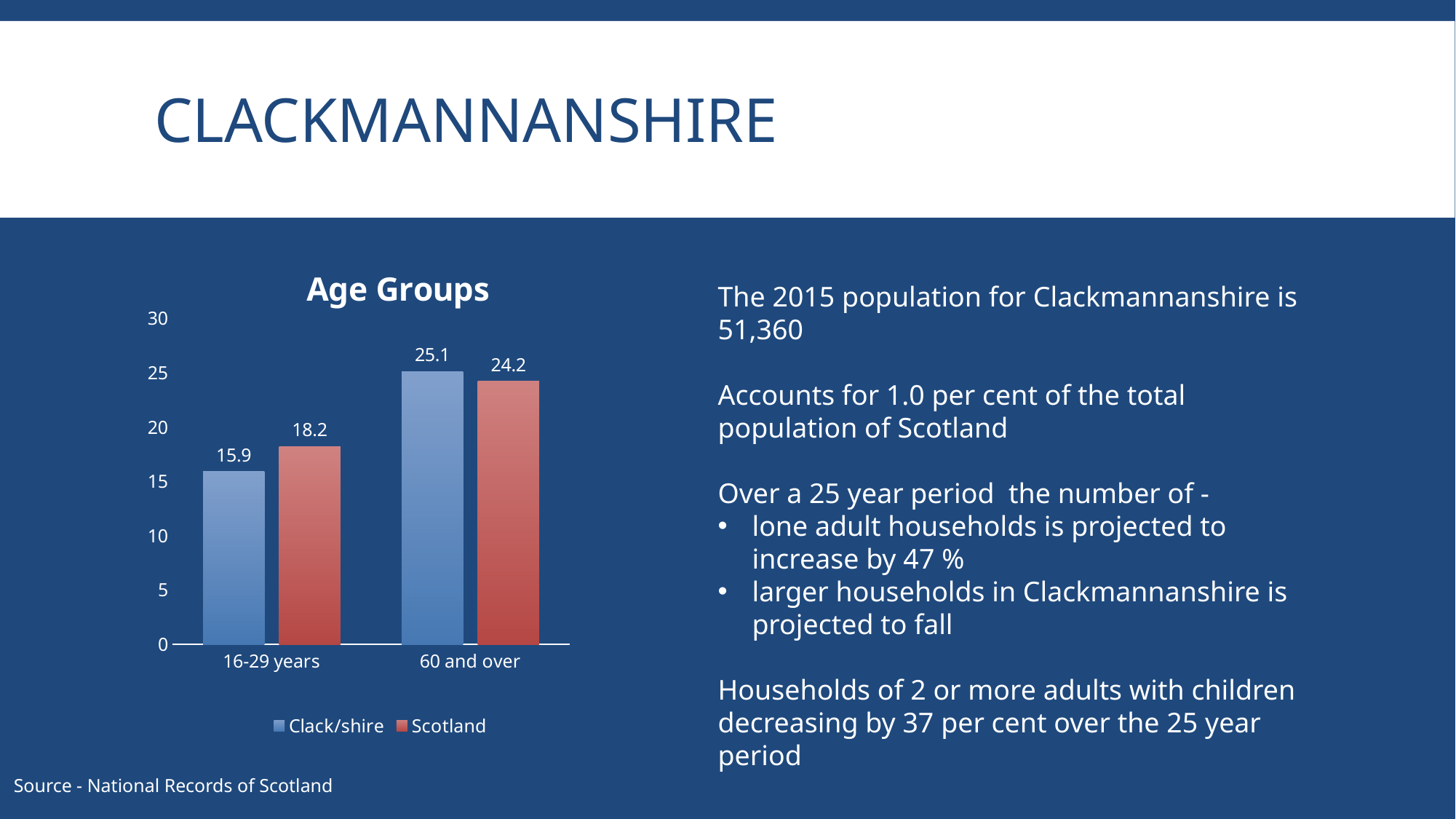
What is the value for Clack/shire in the 16-29 years category? 15.9 Which category has the highest value for Clack/shire? 60 and over What is the value for Scotland in the 16-29 years category? 18.2 Which category has the lowest value for Scotland? 16-29 years What is the title of the chart? Age Groups How many age group categories are shown on the x axis? 2 What kind of chart is shown on the slide? bar chart Which is larger for 60 and over: Clack/shire or Scotland? Clack/shire What is the difference between the Scotland and Clack/shire values for 16-29 years? 2.3 What is the value for Scotland in the 60 and over category? 24.2 Is the value for Clack/shire in the 60 and over category greater or less than 20? greater How many series does the legend list? 2